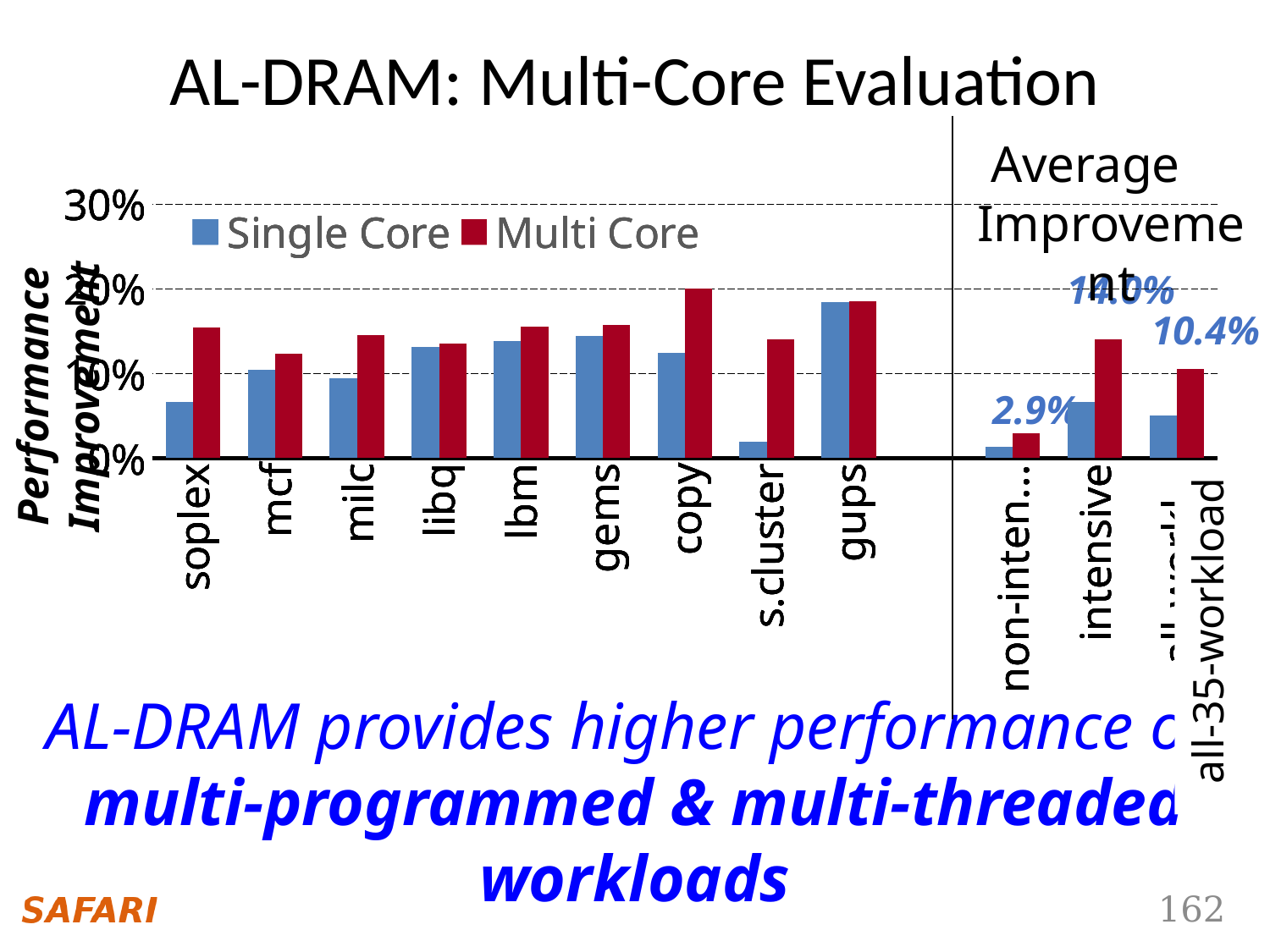
How many benchmark categories are plotted to the left of the vertical divider line? 9 For soplex, which is larger: the Single Core value or the Multi Core value? Multi Core What is the label on the vertical axis? Performance Improvement What value is printed above the all-35-workload group in the Average Improvement section? 10.4% What are the two series named in the legend? Single Core and Multi Core How many series does the legend list? 2 Among the nine benchmarks left of the divider, which has the highest Single Core value? gups Is the Single Core value for s.cluster greater or less than 10%? less Among the nine benchmarks left of the divider, which has the lowest Single Core value? s.cluster What value is printed above the intensive group in the Average Improvement section? 14.0% What kind of chart is shown on the slide? bar chart What is the difference between the printed values for the intensive group (14.0%) and the all-35-workload group (10.4%)? 3.6%